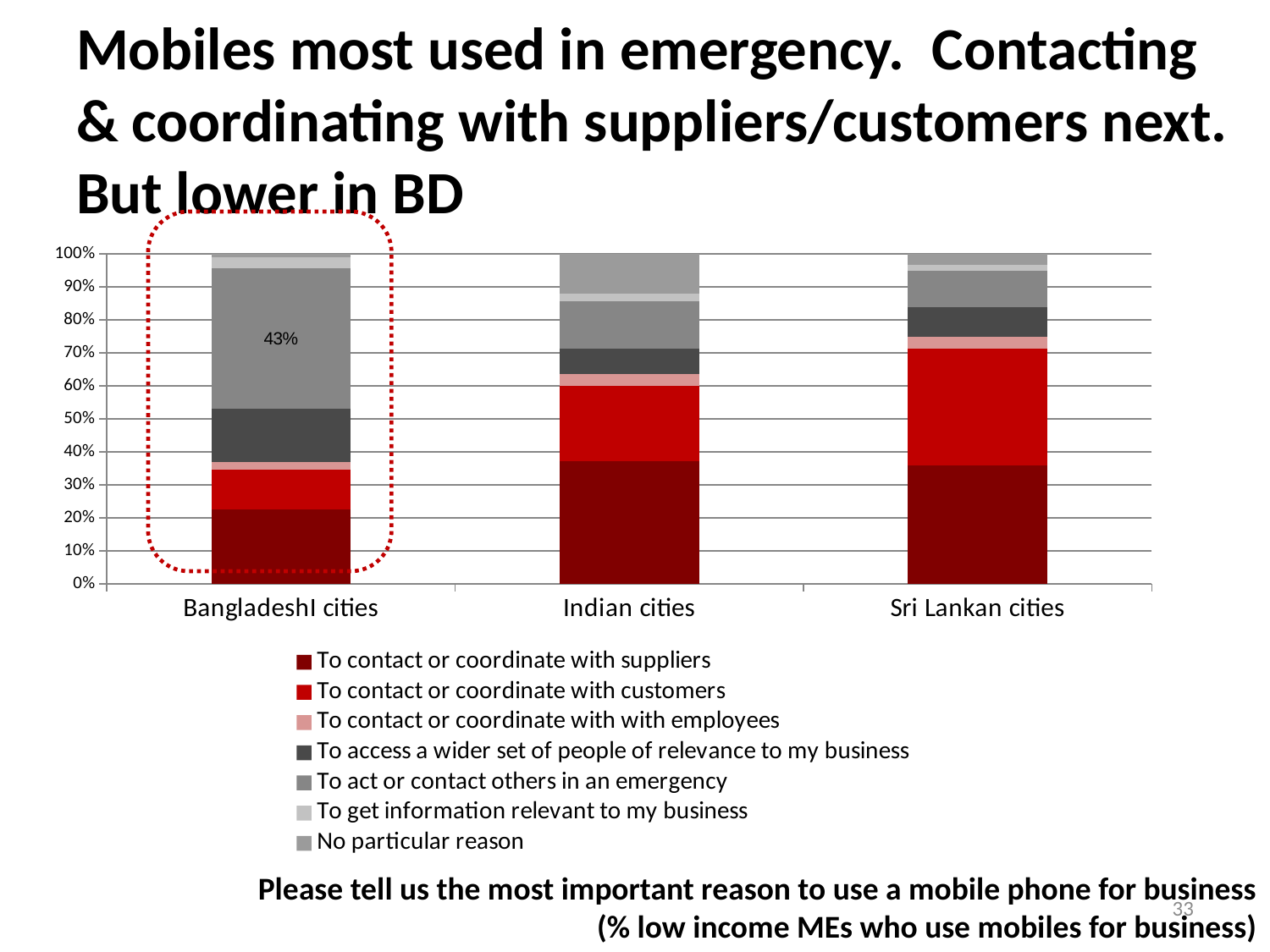
Is the 'To contact or coordinate with suppliers' segment for Indian cities greater or less than 30%? greater Is the 'To contact or coordinate with suppliers' segment for BangladeshI cities greater or less than 30%? less How many series does the legend list? 7 What kind of chart is shown on the slide? Stacked bar chart Which city group has the largest 'To act or contact others in an emergency' segment? BangladeshI cities What percentage is labelled for 'To act or contact others in an emergency' in BangladeshI cities? 43% What is the total height of the stacked bar for Indian cities? 100% Which city group's bar is highlighted with a red dotted outline? BangladeshI cities How many city groups (categories) are shown on the x axis? 3 Is the 'To contact or coordinate with customers' segment for Sri Lankan cities greater or less than 30%? greater Which is larger: the 'To contact or coordinate with suppliers' segment for BangladeshI cities or for Indian cities? Indian cities Which city group has the smallest 'To contact or coordinate with suppliers' segment? BangladeshI cities